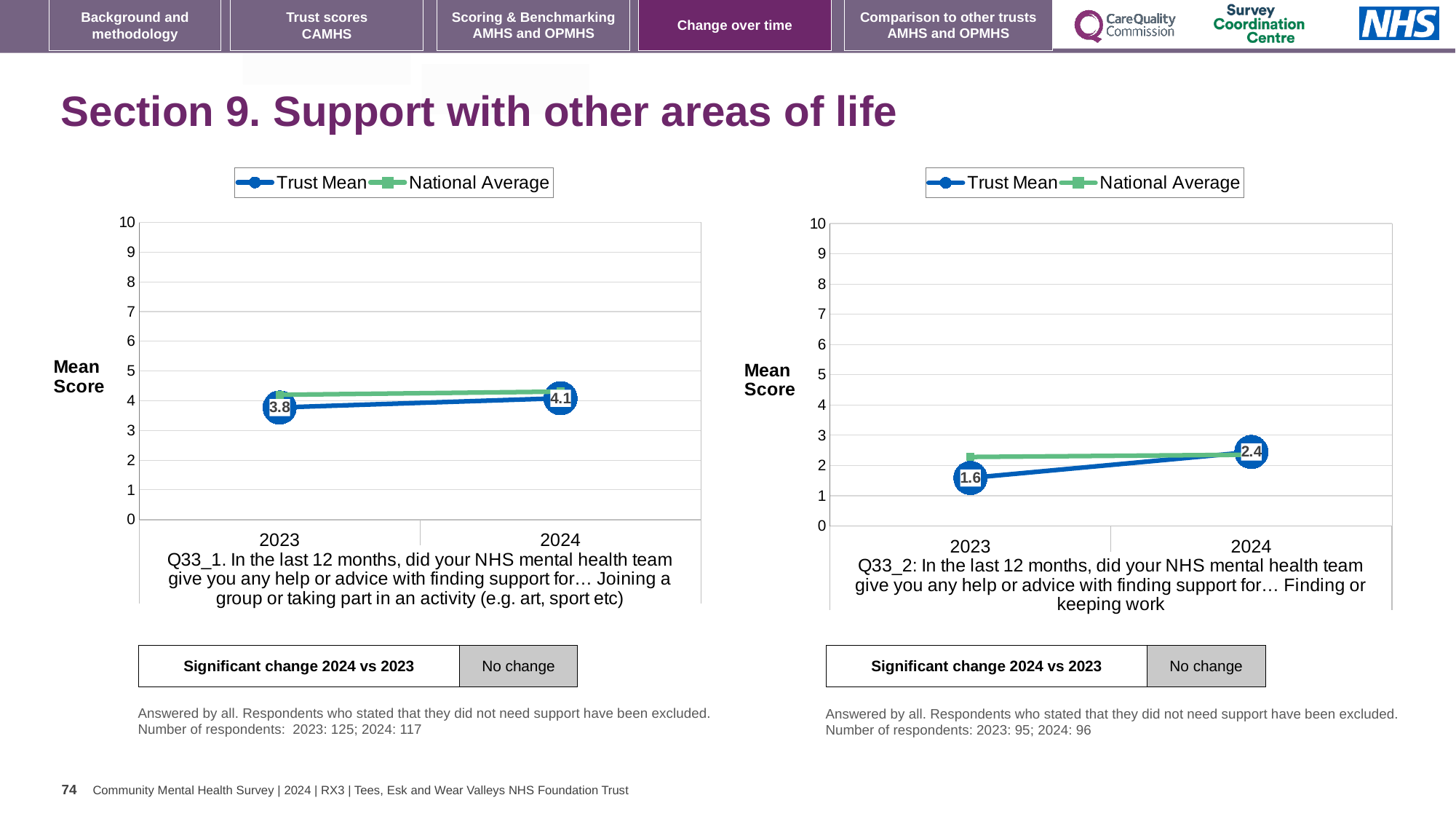
In the left chart (Q33_1), what is the Trust Mean score for 2024? 4.1 In the right chart (Q33_2), is the National Average for 2023 greater or less than 2? greater How many years are plotted on the x axis of the right chart (Q33_2)? 2 In the left chart (Q33_1), does the Trust Mean rise or fall from 2023 to 2024? rise In the right chart (Q33_2), what is the Trust Mean score for 2023? 1.6 How many series does the legend of the left chart list? 2 In the left chart (Q33_1), what is the difference between the Trust Mean for 2024 and 2023? 0.3 What kind of chart is the left chart (Q33_1)? line chart In the left chart (Q33_1), what is the Trust Mean score for 2023? 3.8 In the right chart (Q33_2), by how much did the Trust Mean change from 2023 to 2024? 0.8 In the right chart (Q33_2), what is the Trust Mean score for 2024? 2.4 In the right chart (Q33_2), which year has the higher Trust Mean, 2023 or 2024? 2024